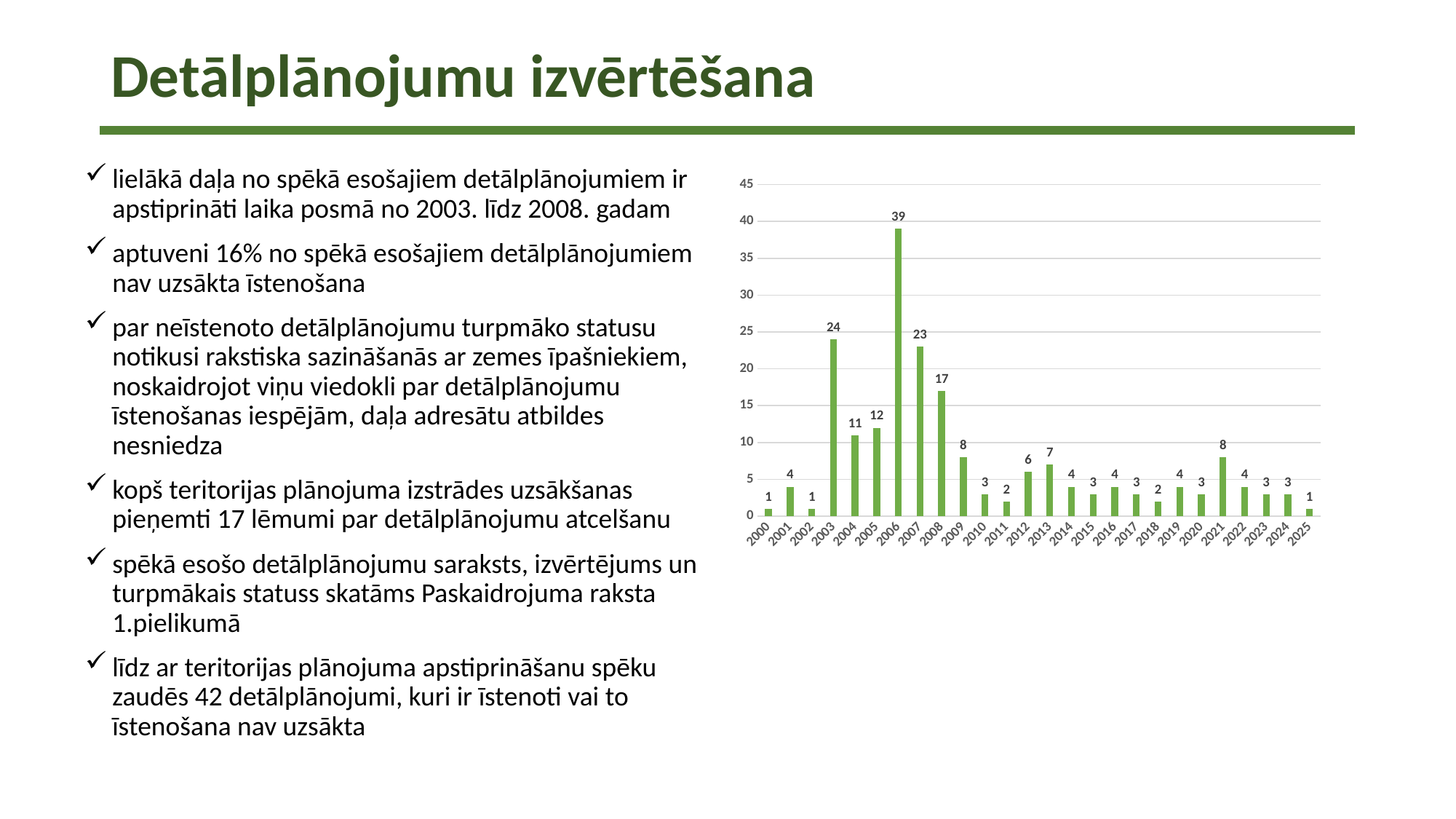
What is the value for 2003? 24 What kind of chart is shown on the slide? bar chart Which year has the highest value? 2006 What is the difference between the values for 2003 and 2008? 7 What is the value for 2013? 7 Which is larger, the value for 2004 or the value for 2005? 2005 What is the difference between the values for 2006 and 2007? 16 What is the value for 2006? 39 Which is larger, the value for 2009 or the value for 2021? They are equal (8) Do the values rise or fall from 2006 to 2011? fall How many years are shown on the x axis? 26 Is the value for 2006 greater or less than 35? greater